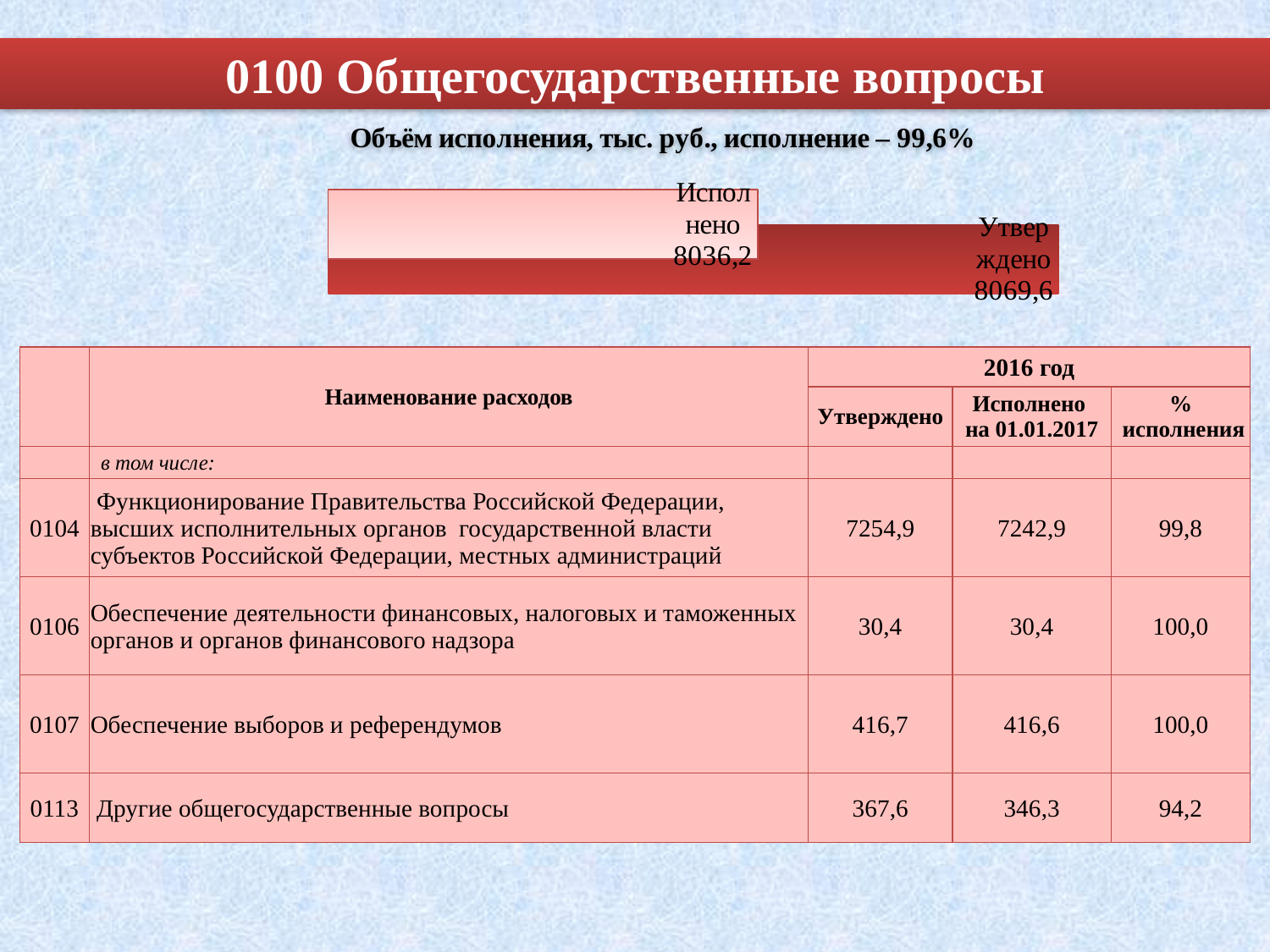
What execution percentage is stated in the chart's title? 99,6% How many bars are plotted on the chart? 2 Which category on the chart has the highest value? Утверждено What is the difference between the Утверждено and Исполнено values on the chart? 33,4 Which bar on the chart has the higher value, Исполнено or Утверждено? Утверждено What kind of chart is shown on the slide? bar chart What is the title shown above the chart? Объём исполнения, тыс. руб., исполнение – 99,6% Which category on the chart has the lowest value? Исполнено What value is shown for Утверждено on the chart? 8069,6 What value is shown for Исполнено on the chart? 8036,2